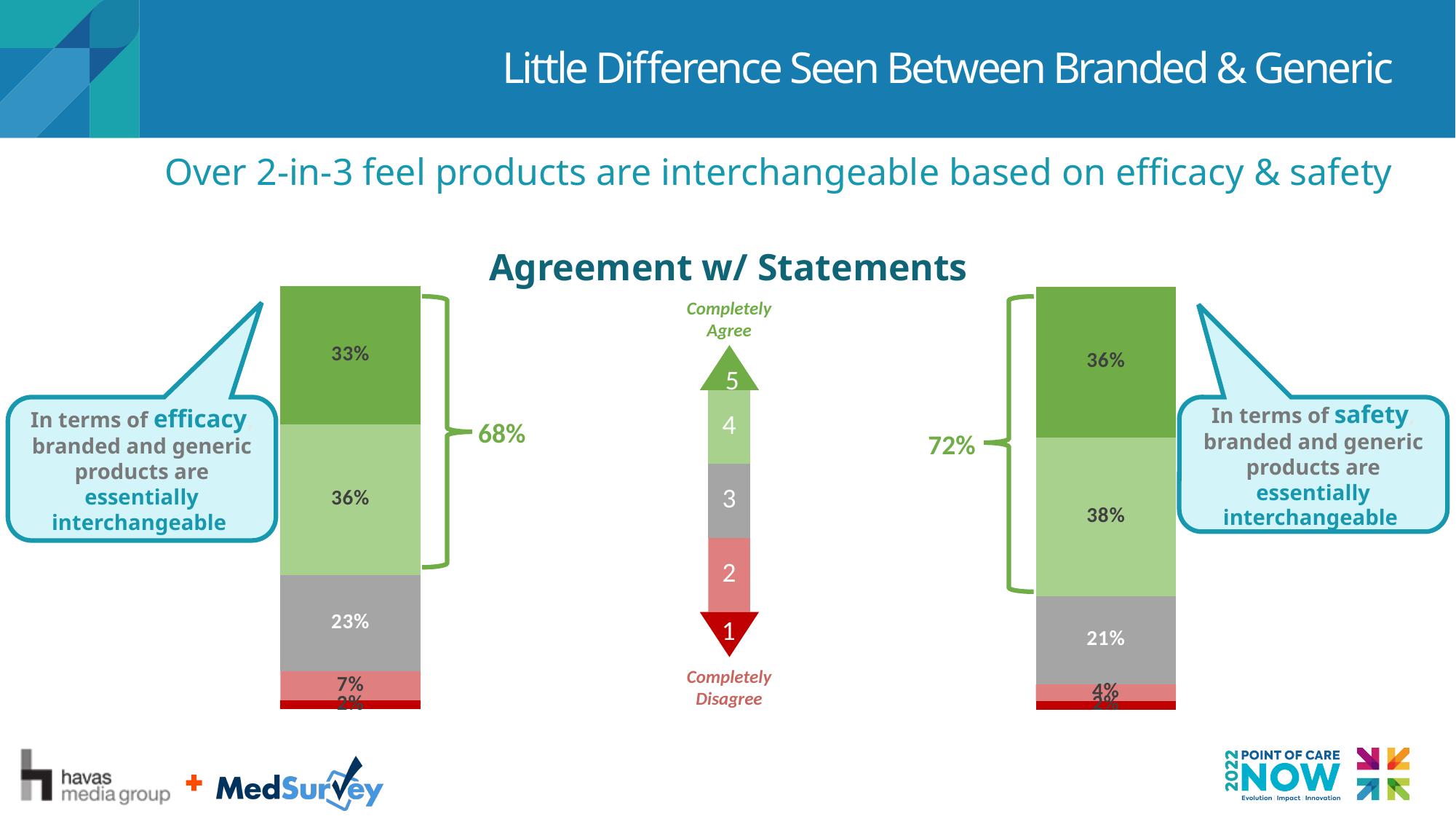
What type of chart is used to show agreement with the statements? Stacked bar chart Which statement has the higher top-two-box agreement: efficacy (68%) or safety (72%)? Safety In the safety chart (right), what percentage gave a rating of 4? 38% What is the difference between the rating-3 share in the efficacy chart (23%) and the rating-3 share in the safety chart (21%)? 2 percentage points What is the title shown above the charts? Agreement w/ Statements In the efficacy chart (left), which rating level has the largest share? 4 (36%) What combined percentage of top-two-box agreement (ratings 4 and 5) is shown by the bracket for the efficacy chart (left)? 68% In the efficacy chart (left), what percentage completely agree (rating 5) that branded and generic products are essentially interchangeable? 33% In the safety chart (right), what percentage gave a rating of 2? 4% In the efficacy chart (left), what percentage gave a neutral rating of 3? 23% In the safety chart (right), which rating level has the largest share? 4 (38%) What combined percentage of top-two-box agreement (ratings 4 and 5) is shown by the bracket for the safety chart (right)? 72%